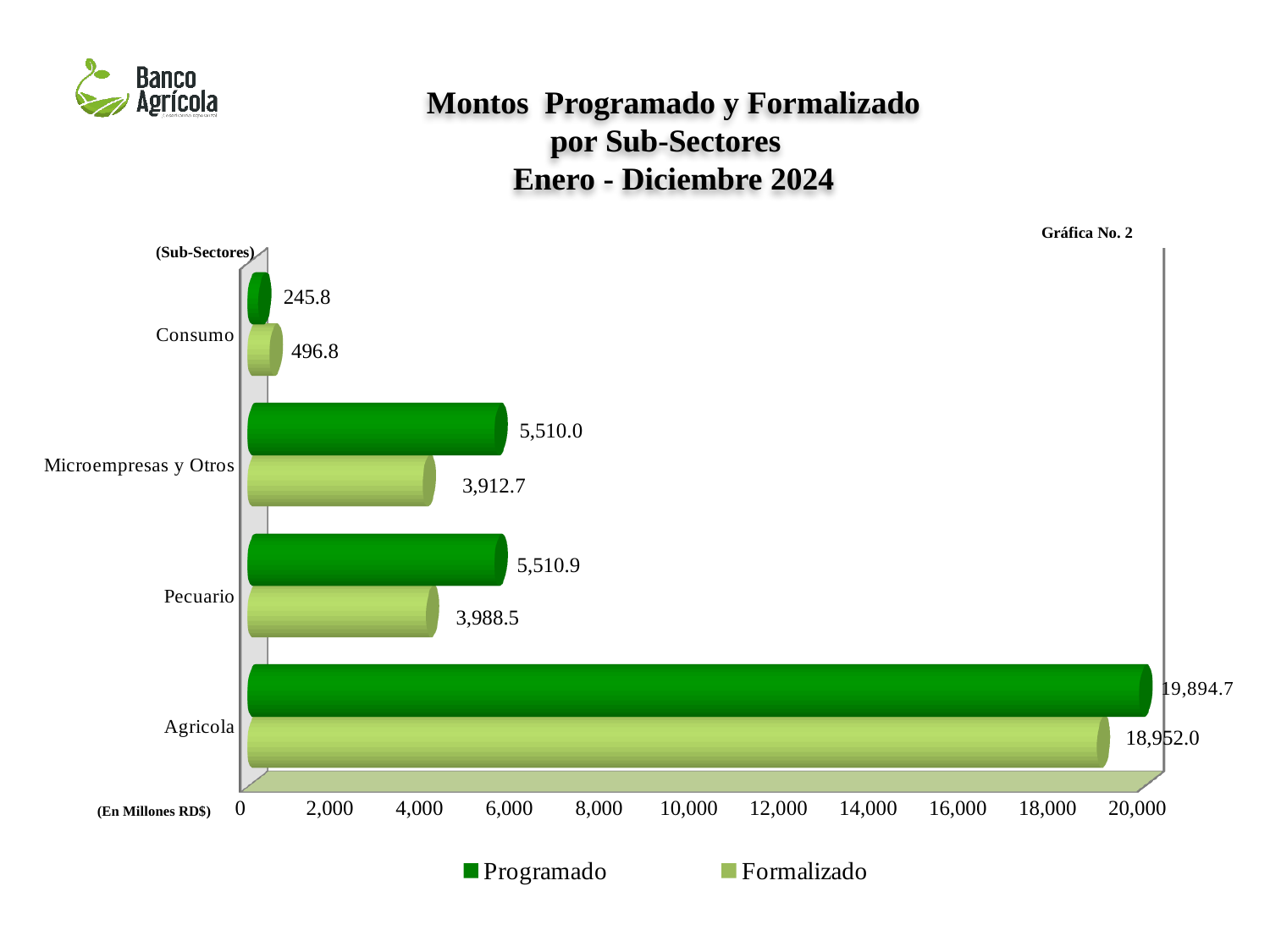
What is the Programado value for Microempresas y Otros? 5,510.0 How many series does the legend list? 2 Which sub-sector has the lowest Programado value? Consumo What is the difference between the Formalizado and Programado values for Consumo? 251.0 How many sub-sectors are shown on the chart? 4 For Consumo, which is larger: the Programado value or the Formalizado value? Formalizado What is the Programado value for Agricola? 19,894.7 What is the Formalizado value for Consumo? 496.8 What type of chart is shown on the slide? Bar chart What is the Formalizado value for Pecuario? 3,988.5 What is the difference between the Programado and Formalizado values for Agricola? 942.7 Which sub-sector has the highest Formalizado value? Agricola